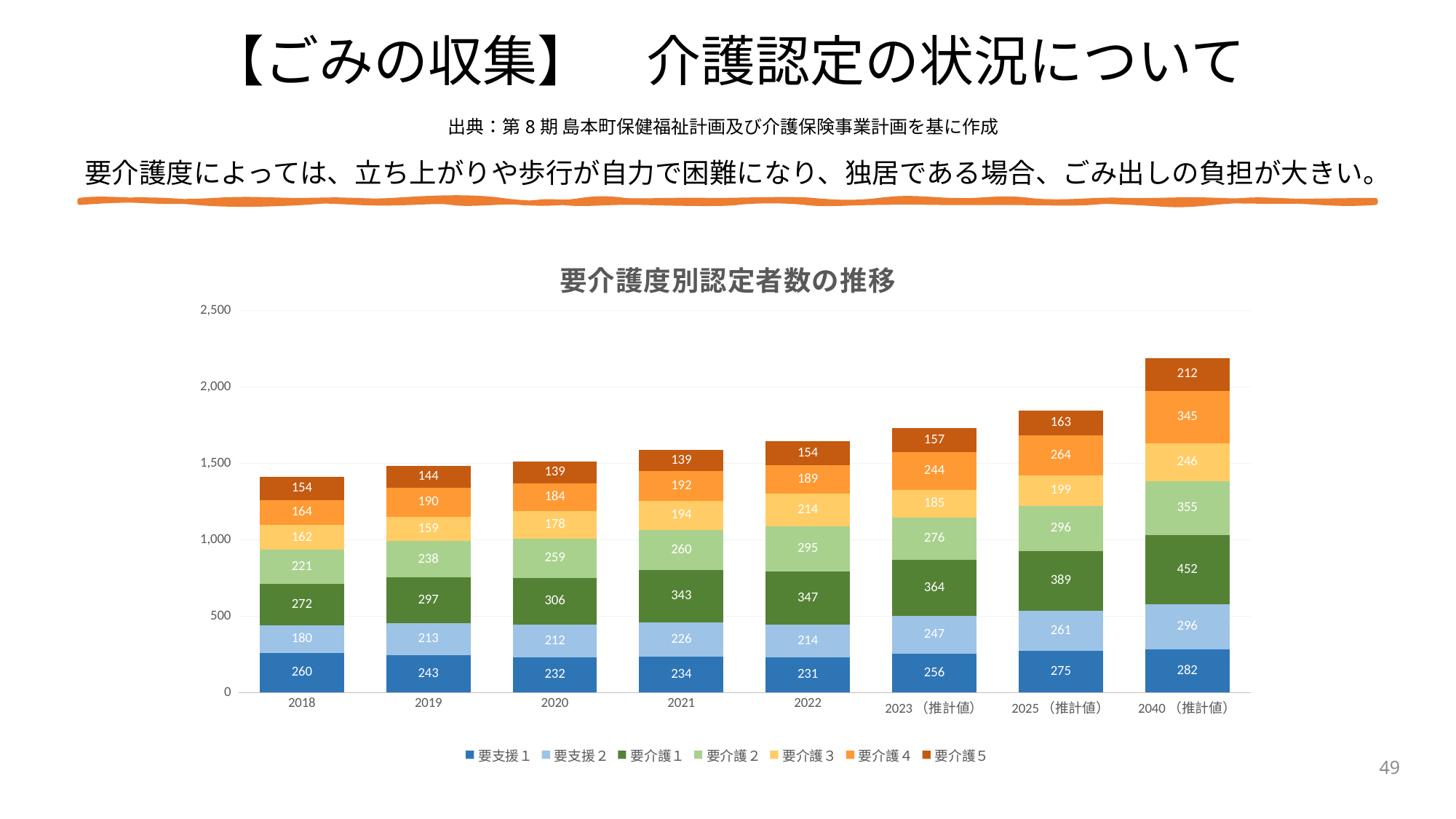
Which year has the lowest value for 要支援１? 2022 What is the value for 要介護５ in 2040（推計値）? 212 Which year has the highest value for 要介護１? 2040（推計値） What is the title of the chart? 要介護度別認定者数の推移 How many series does the legend list? 7 What is the difference between the 要介護２ values for 2040（推計値） and 2018? 134 What is the total of the stacked bar for 2018? 1413 Which is larger, the 要介護４ value in 2019 or the 要介護４ value in 2021? 2021 What is the value for 要支援２ in 2023（推計値）? 247 How many categories (years) are shown on the x axis? 8 What is the value for 要介護１ in 2020? 306 What type of chart is shown on the slide? Stacked bar chart